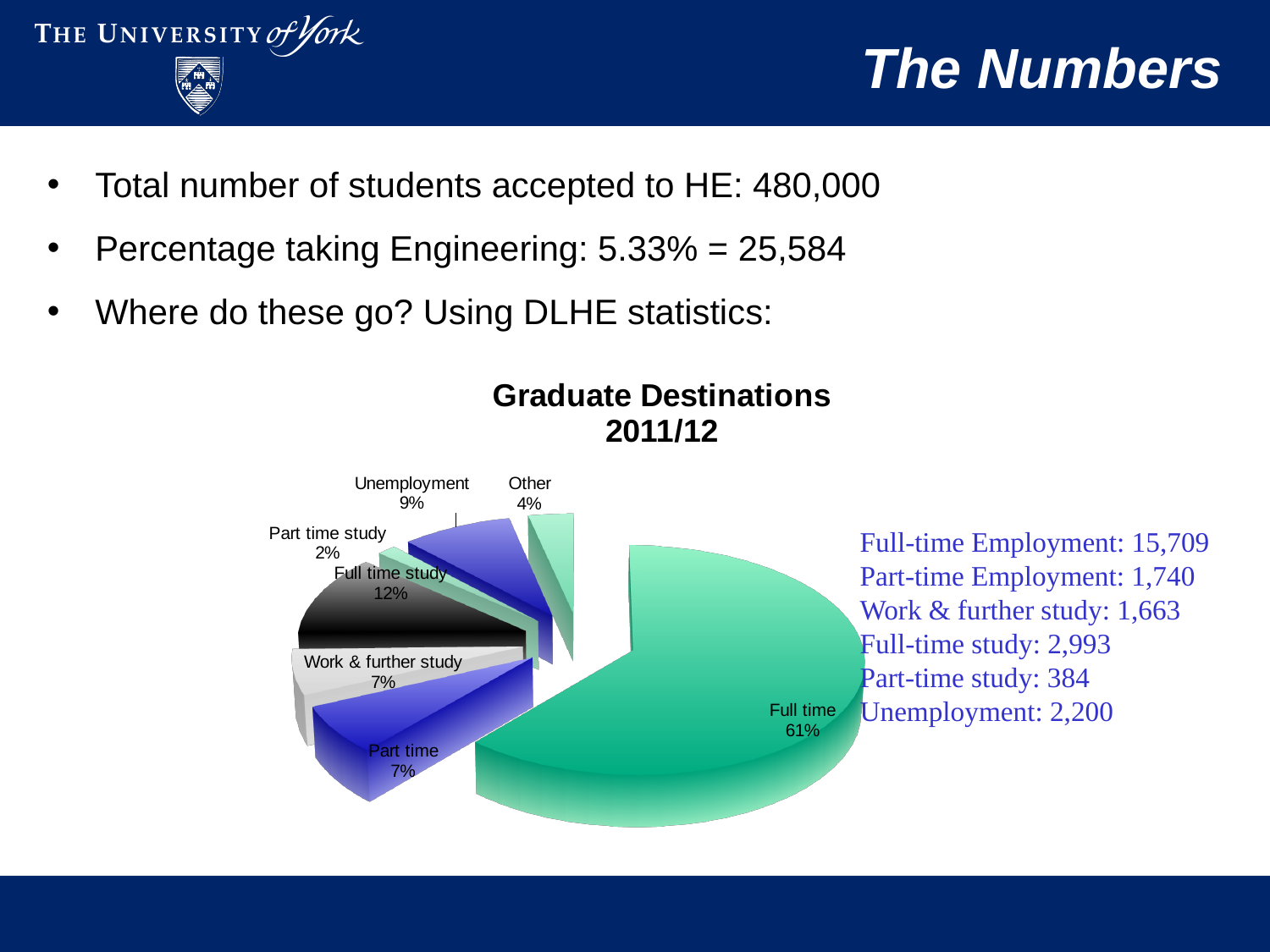
What percentage is shown for Unemployment? 9% Which is larger, the Unemployment slice or the Other slice? Unemployment Which slice of the pie is the smallest? Part time study What percentage is shown for Full time study? 12% What is the difference in percentage points between Full time study and Unemployment? 3 What percentage is shown for Part time study? 2% How many slices does the pie chart have? 7 What percentage is shown for Other? 4% What share of the pie is labelled Full time? 61% What kind of chart is shown on the slide? Pie chart Which slice of the pie is the largest? Full time What is the title of the chart? Graduate Destinations 2011/12